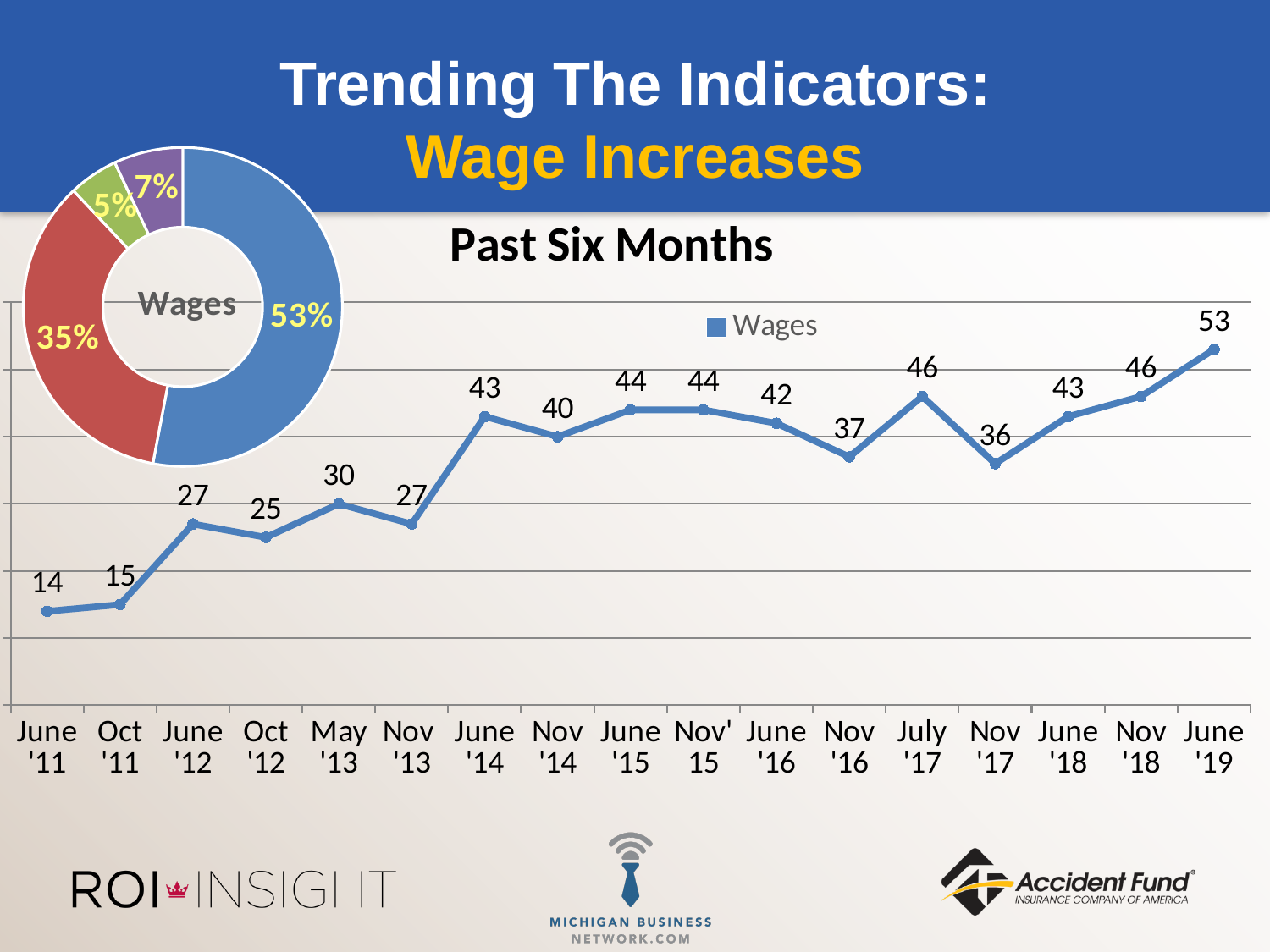
How many slices does the donut chart have? 4 In the line chart, which is larger, the value for July '17 or the value for Nov '16? July '17 What kind of chart is the chart titled Past Six Months? line chart In the line chart, do the values generally rise or fall from June '11 to June '19? rise In the line chart, which date has the highest value? June '19 In the donut chart, what is the share of the red slice? 35% How many data points are plotted in the line chart? 17 In the line chart, what is the value for Nov '17? 36 In the donut chart, what share does the largest slice have? 53% In the line chart, what is the value for June '19? 53 In the line chart, which date has the lowest value? June '11 In the line chart, what is the difference between the values for June '19 and June '11? 39